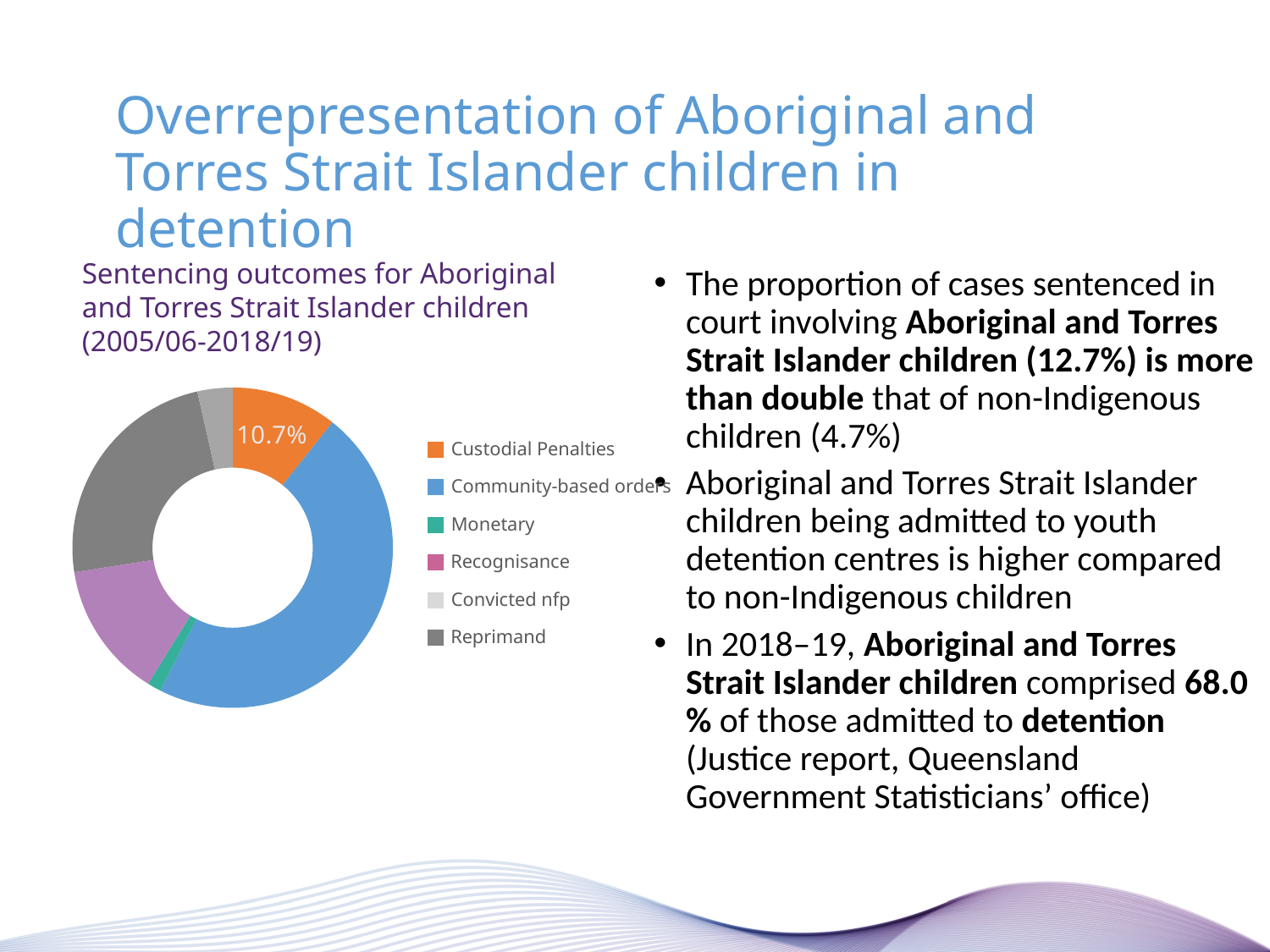
What percentage is shown for Custodial Penalties in the doughnut chart? 10.7% Which category is shown in orange in the chart? Custodial Penalties How many sentencing outcome categories does the chart show? 6 Which sentencing outcome has the smallest slice in the chart? Monetary What share of the chart does the Custodial Penalties slice represent? 10.7% What is the title of the chart? Sentencing outcomes for Aboriginal and Torres Strait Islander children (2005/06-2018/19) Which slice is larger, Reprimand or Recognisance? Reprimand Which sentencing outcome has the largest slice in the chart? Community-based orders What type of chart is used to show the sentencing outcomes? Doughnut (pie) chart Which slice is larger, Community-based orders or Reprimand? Community-based orders